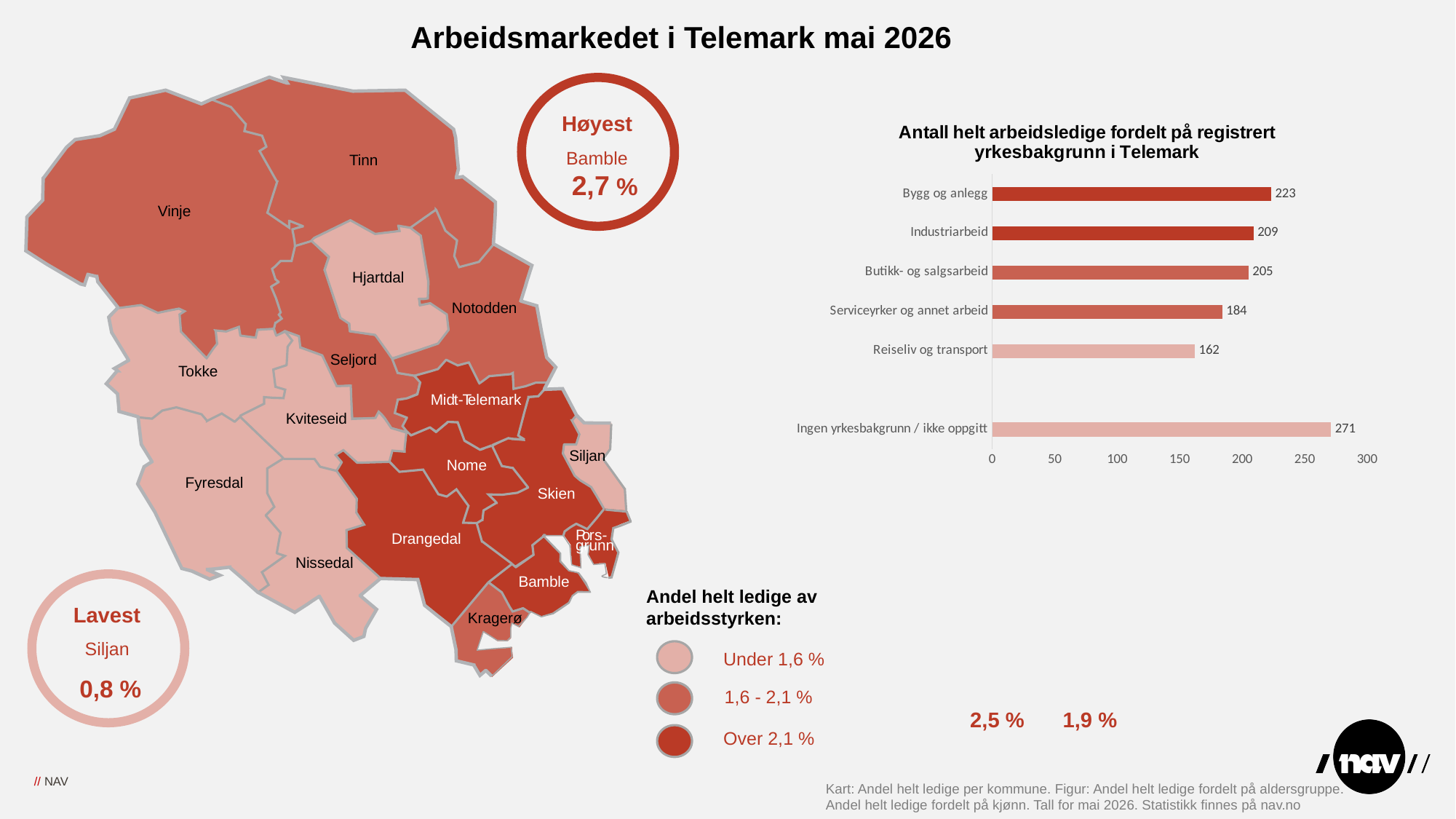
In the chart 'Antall helt arbeidsledige fordelt på registrert yrkesbakgrunn i Telemark', what is the value for Reiseliv og transport? 162 In the chart 'Antall helt arbeidsledige fordelt på registrert yrkesbakgrunn i Telemark', which category has the highest value? Ingen yrkesbakgrunn / ikke oppgitt How many categories are shown in the chart 'Antall helt arbeidsledige fordelt på registrert yrkesbakgrunn i Telemark'? 6 In the chart 'Antall helt arbeidsledige fordelt på registrert yrkesbakgrunn i Telemark', what is the value for Ingen yrkesbakgrunn / ikke oppgitt? 271 In the chart 'Antall helt arbeidsledige fordelt på registrert yrkesbakgrunn i Telemark', which category has the lowest value? Reiseliv og transport What kind of chart is 'Antall helt arbeidsledige fordelt på registrert yrkesbakgrunn i Telemark'? Bar chart In the chart 'Antall helt arbeidsledige fordelt på registrert yrkesbakgrunn i Telemark', what is the difference between Ingen yrkesbakgrunn / ikke oppgitt and Reiseliv og transport? 109 What is the maximum value shown on the x axis of the chart 'Antall helt arbeidsledige fordelt på registrert yrkesbakgrunn i Telemark'? 300 In the chart 'Antall helt arbeidsledige fordelt på registrert yrkesbakgrunn i Telemark', is the value for Serviceyrker og annet arbeid greater or less than 200? less In the chart 'Antall helt arbeidsledige fordelt på registrert yrkesbakgrunn i Telemark', what is the value for Bygg og anlegg? 223 In the chart 'Antall helt arbeidsledige fordelt på registrert yrkesbakgrunn i Telemark', which is larger: Industriarbeid or Butikk- og salgsarbeid? Industriarbeid In the chart 'Antall helt arbeidsledige fordelt på registrert yrkesbakgrunn i Telemark', what is the difference between Bygg og anlegg and Serviceyrker og annet arbeid? 39